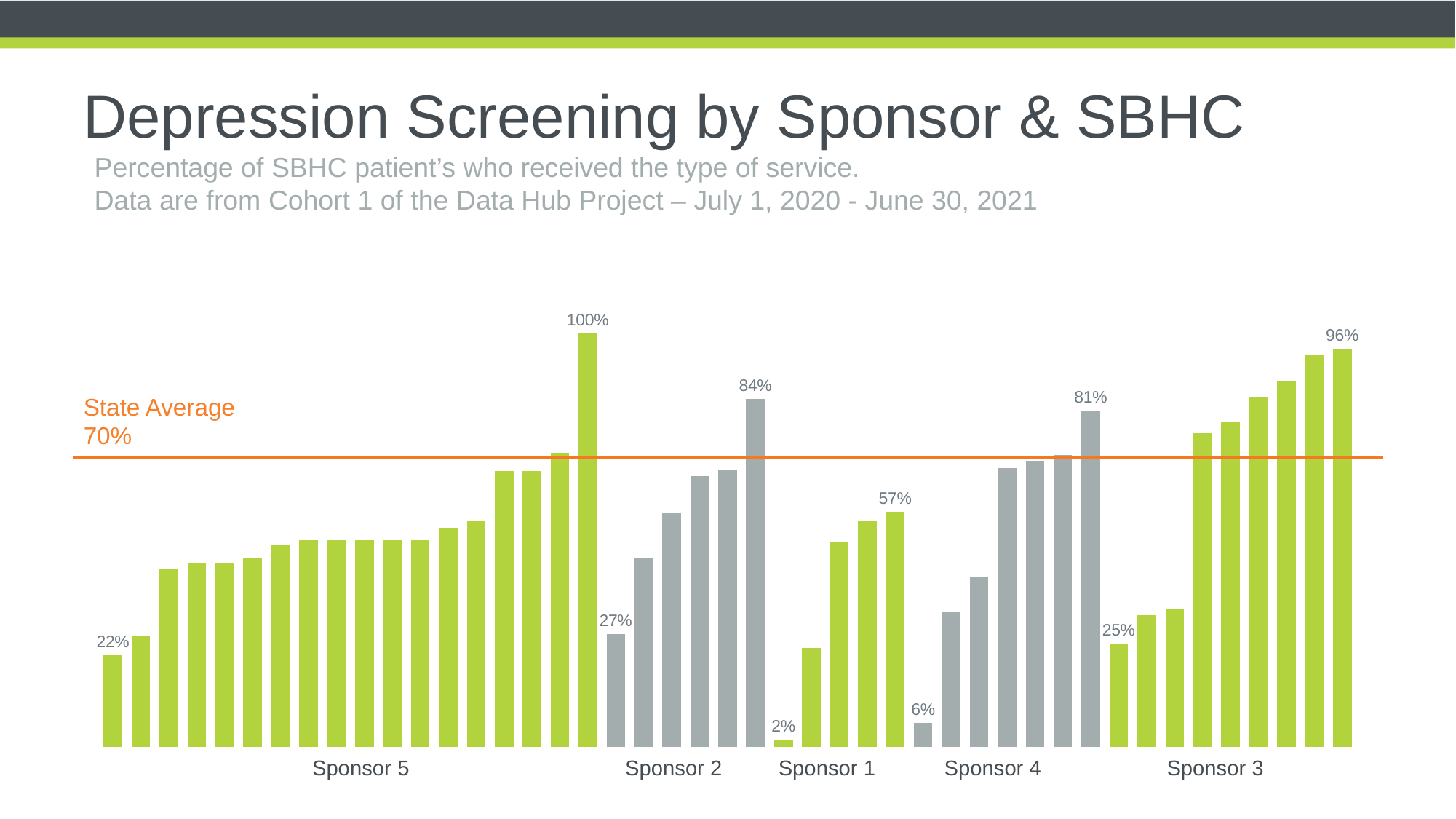
What is the lowest labeled value in the Sponsor 4 group? 6% What is the State Average value marked by the horizontal line? 70% What is the highest labeled value in the Sponsor 5 group? 100% What is the highest labeled value in the Sponsor 1 group? 57% What is the difference between the highest and lowest labeled values in the Sponsor 5 group? 78% Which is larger: the highest value in the Sponsor 2 group or the highest value in the Sponsor 4 group? Sponsor 2 (84%) What is the lowest labeled value on the chart? 2% What is the highest labeled value in the Sponsor 3 group? 96% What is the lowest labeled value in the Sponsor 2 group? 27% What kind of chart is shown on the slide? bar chart Which sponsor group contains the tallest bar on the chart? Sponsor 5 How many sponsor groups are labeled on the x axis? 5